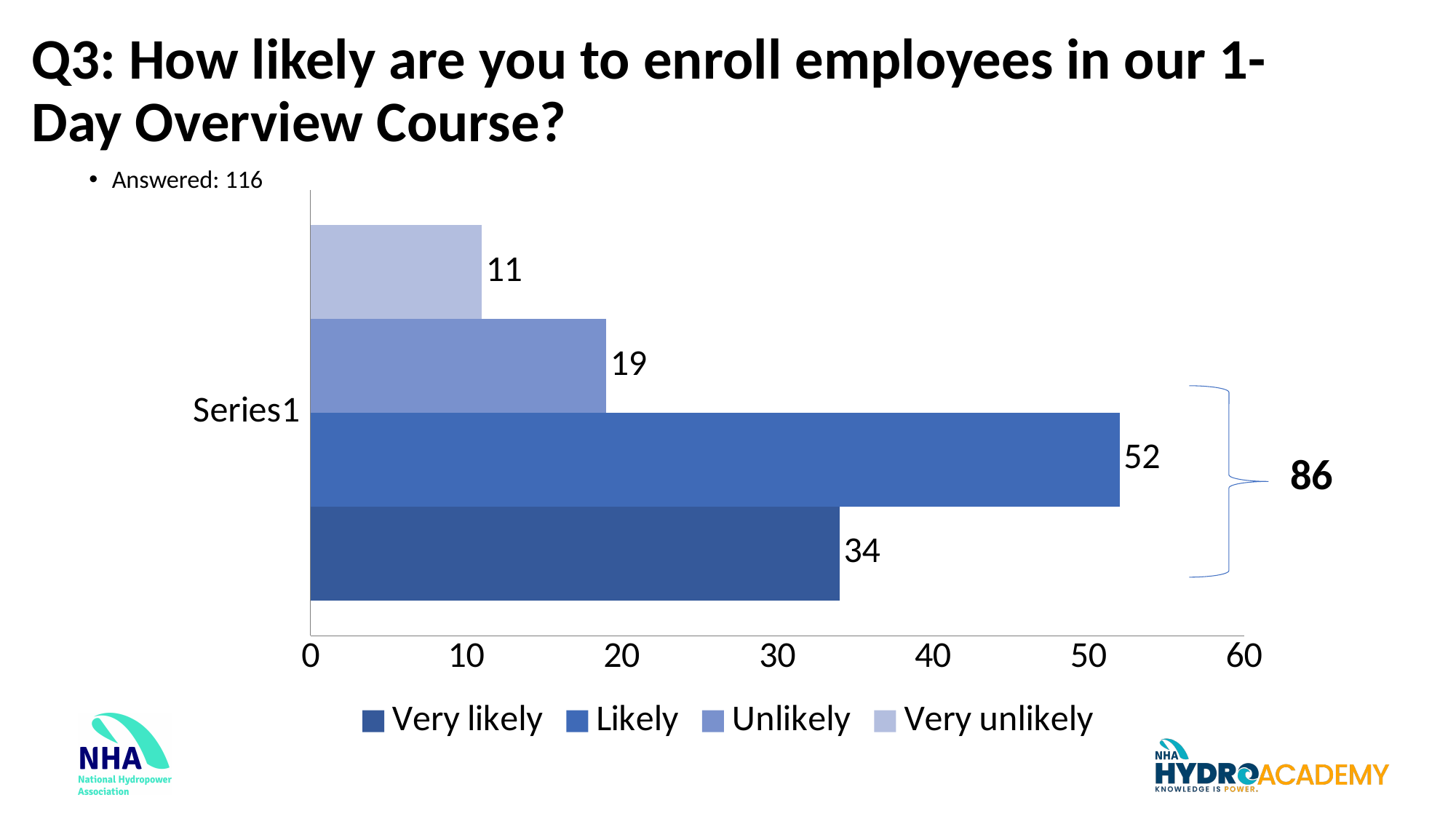
Which series has the lowest value? Very unlikely Is the value for Very likely greater or less than 30? greater Which is larger, the value for Unlikely or the value for Very unlikely? Unlikely What is the difference between the values for Likely and Very likely? 18 What is the value for Very unlikely? 11 What is the value for Unlikely? 19 How many series does the legend list? 4 What is the value for Likely? 52 What combined total is shown by the bracket next to the Very likely and Likely bars? 86 Which series has the highest value? Likely What is the value for Very likely? 34 What kind of chart is shown on the slide? bar chart